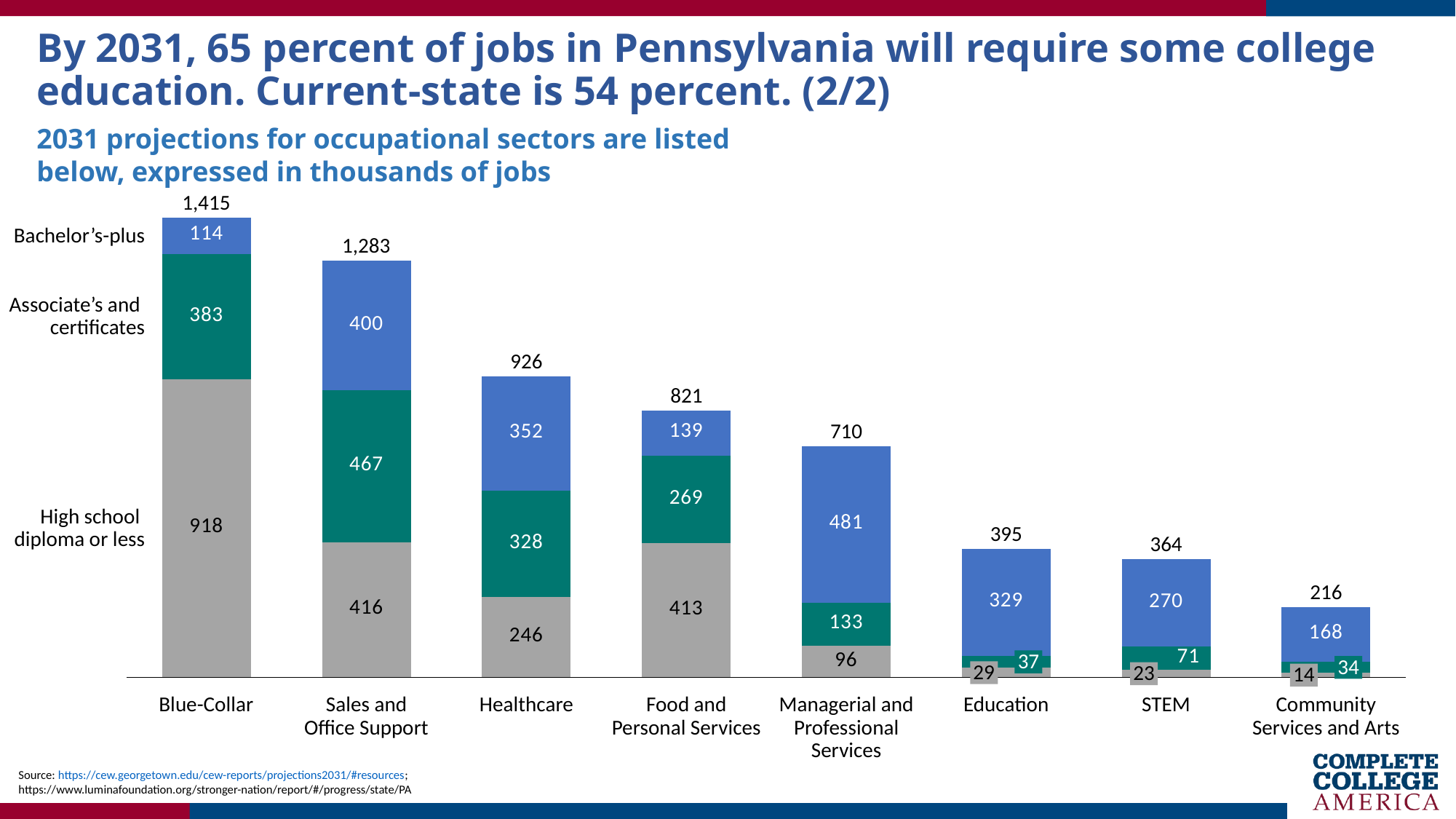
Do the total values rise or fall moving from left to right across the sectors? Fall Which occupational sector has the lowest total projected jobs? Community Services and Arts What type of chart is shown on the slide? Stacked bar chart What is the total projected number of jobs for Sales and Office Support? 1,283 What is the Associate's and certificates value for Healthcare? 328 Which occupational sector has the highest total projected jobs? Blue-Collar How many education-level series are shown in the stacked bars? 3 Which is larger: the Bachelor's-plus value for Education or for STEM? Education What is the projected number of Blue-Collar jobs (in thousands) requiring a high school diploma or less? 918 What is the difference between the total for Healthcare and the total for Food and Personal Services? 105 How many occupational sectors are shown on the chart? 8 What is the Bachelor's-plus value for Managerial and Professional Services? 481